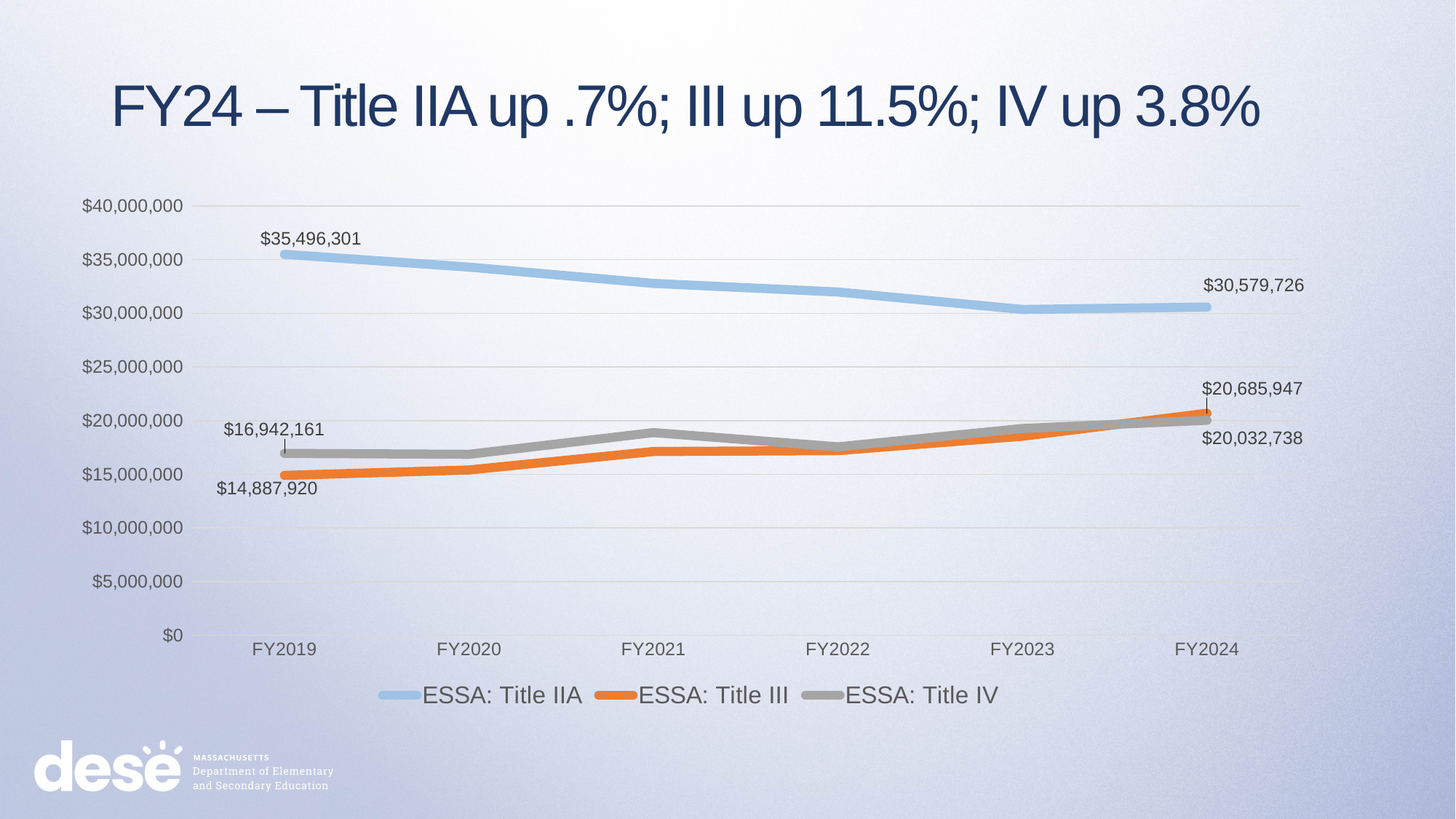
What is the value for ESSA: Title IIA in FY2019? $35,496,301 What is the value for ESSA: Title IV in FY2019? $16,942,161 What is the value for ESSA: Title III in FY2024? $20,685,947 Which series has the highest value in FY2024? ESSA: Title IIA Is the value for ESSA: Title IIA in FY2021 greater or less than $30,000,000? greater Which series has the lowest value in FY2019? ESSA: Title III What type of chart is shown on the slide? Line chart In FY2024, which is larger: ESSA: Title III or ESSA: Title IV? ESSA: Title III Does the ESSA: Title IIA line rise or fall from FY2019 to FY2024? Fall How many series does the legend list? 3 How many fiscal years are plotted along the x axis? 6 By how much did ESSA: Title IIA decrease from FY2019 to FY2024? $4,916,575